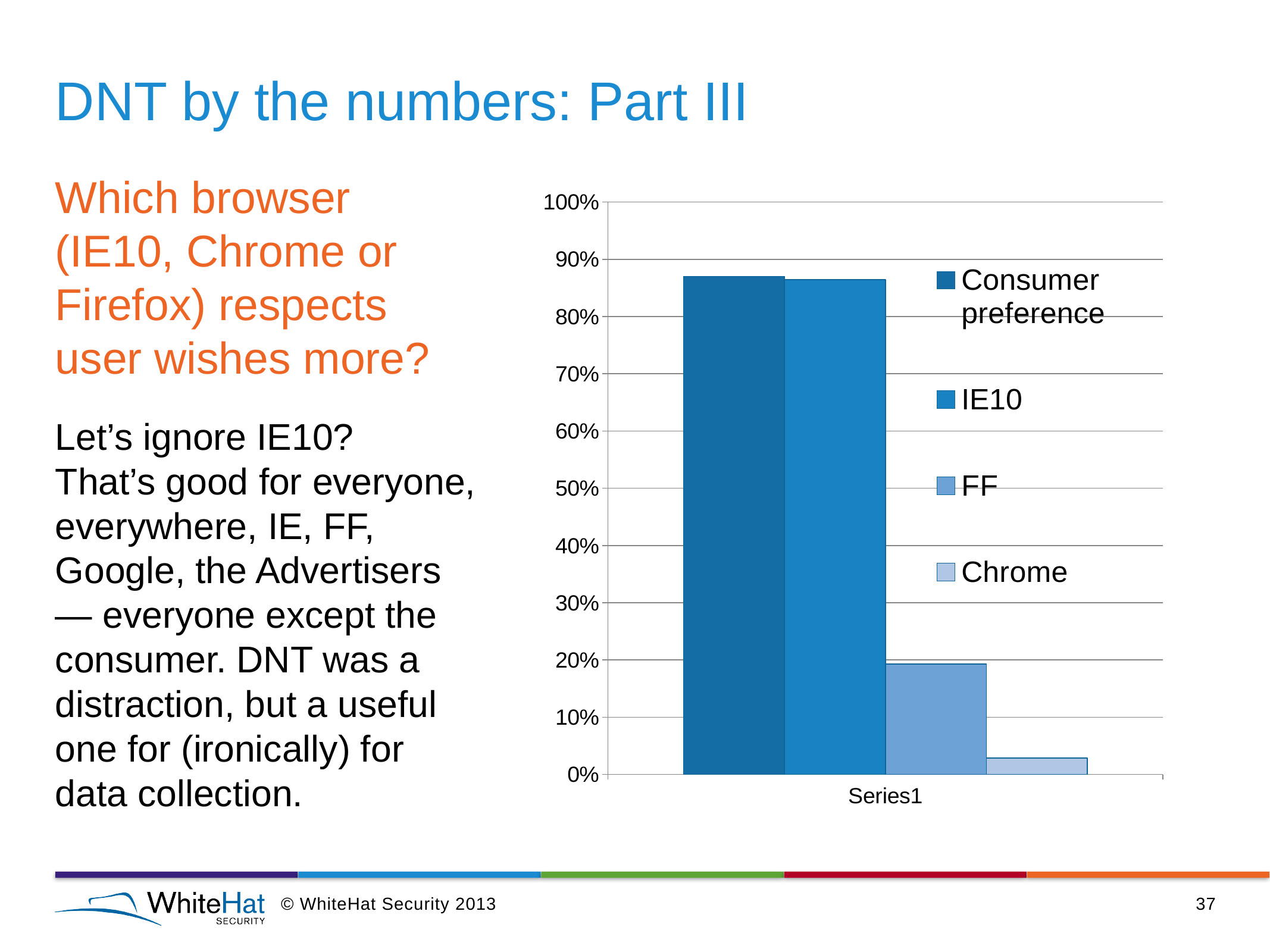
What is the first entry listed in the chart legend? Consumer preference Is the value for Consumer preference greater or less than 80%? greater Is the value for Chrome greater or less than 10%? less Is the value for FF greater or less than 30%? less How many series does the chart legend list? 4 Which is larger, the value for FF or the value for Chrome? FF What is the category label shown on the x axis of the chart? Series1 Which series has the lowest bar in the chart? Chrome Which is larger, the value for IE10 or the value for FF? IE10 What kind of chart is shown on the slide? bar chart